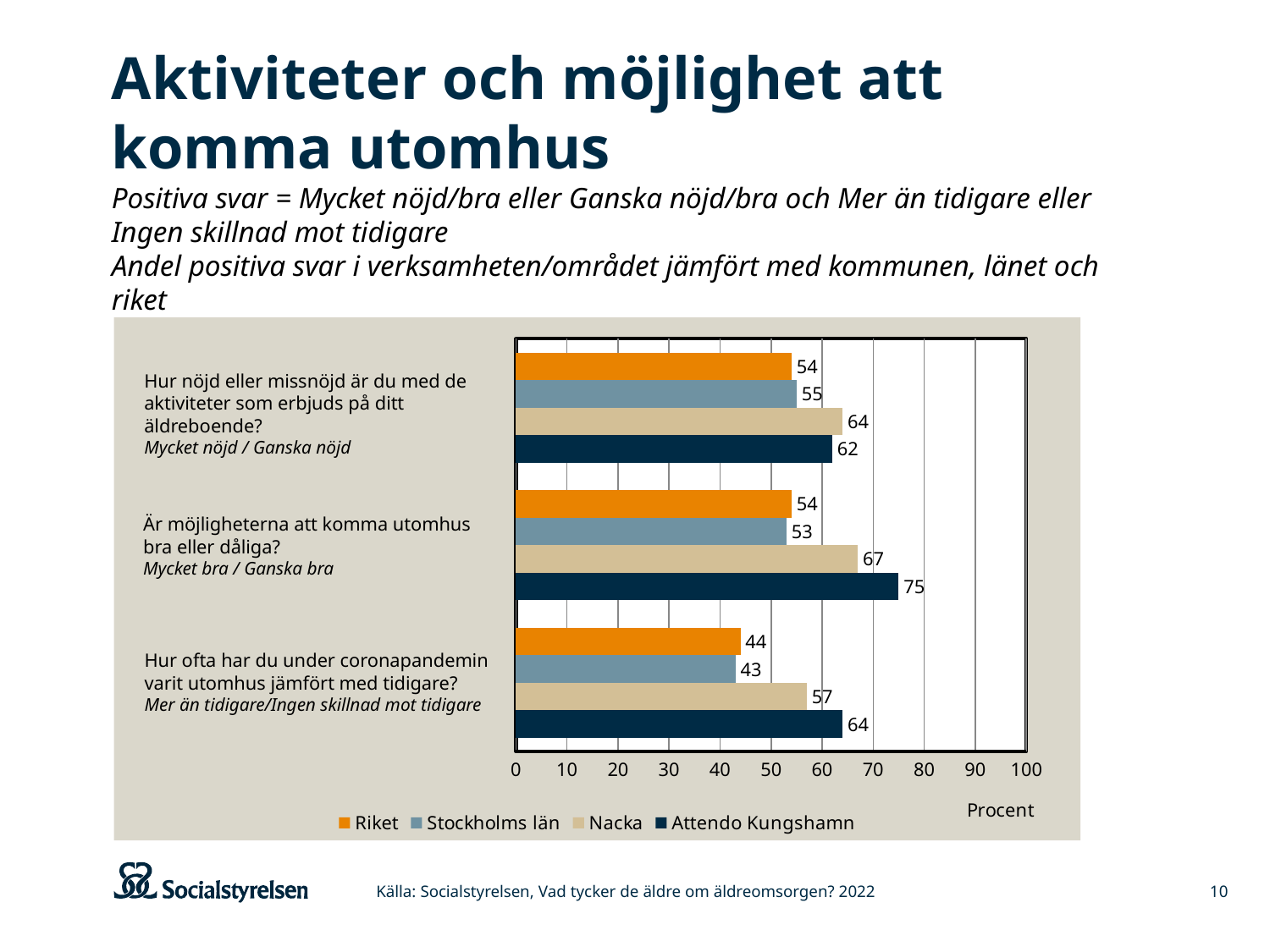
What is the value for Nacka for the question 'Hur nöjd eller missnöjd är du med de aktiviteter som erbjuds på ditt äldreboende?' 64 What label is shown on the horizontal axis of the chart? Procent How many question categories are plotted on the chart? 3 What is the value for Stockholms län for the question 'Hur ofta har du under coronapandemin varit utomhus jämfört med tidigare?' 43 Which series has the lowest value for the question 'Hur ofta har du under coronapandemin varit utomhus jämfört med tidigare?' Stockholms län What type of chart is shown on the slide? Bar chart How many series does the legend list? 4 Which series has the highest value for the question 'Är möjligheterna att komma utomhus bra eller dåliga?' Attendo Kungshamn What is the value for Attendo Kungshamn for the question 'Är möjligheterna att komma utomhus bra eller dåliga?' 75 Is the value for Riket for the question 'Hur ofta har du under coronapandemin varit utomhus jämfört med tidigare?' greater or less than 50? less For the question 'Hur nöjd eller missnöjd är du med de aktiviteter som erbjuds på ditt äldreboende?', which is larger: Nacka or Attendo Kungshamn? Nacka What is the difference between Attendo Kungshamn and Riket for the question 'Är möjligheterna att komma utomhus bra eller dåliga?' 21